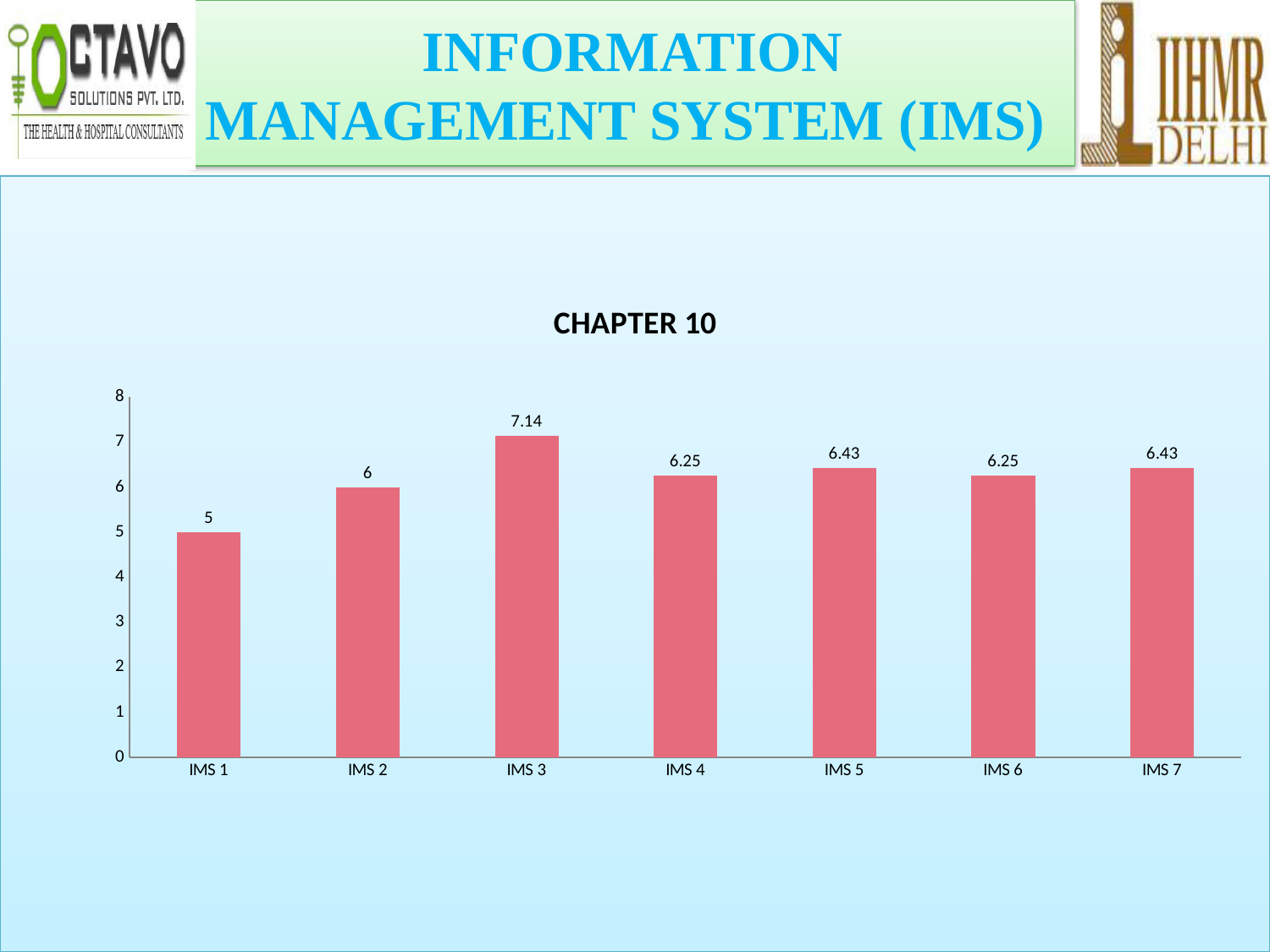
What is the value for IMS 1? 5 What is the title of the chart? CHAPTER 10 What kind of chart is shown on the slide? Bar chart What is the value for IMS 3? 7.14 What is the value for IMS 6? 6.25 Which category has the lowest value? IMS 1 Is the value for IMS 7 greater or less than 6? greater What is the value for IMS 5? 6.43 Which category has the highest value? IMS 3 How many categories are shown on the x axis? 7 Which is larger, the value for IMS 2 or the value for IMS 4? IMS 4 What is the difference between the values for IMS 3 and IMS 1? 2.14